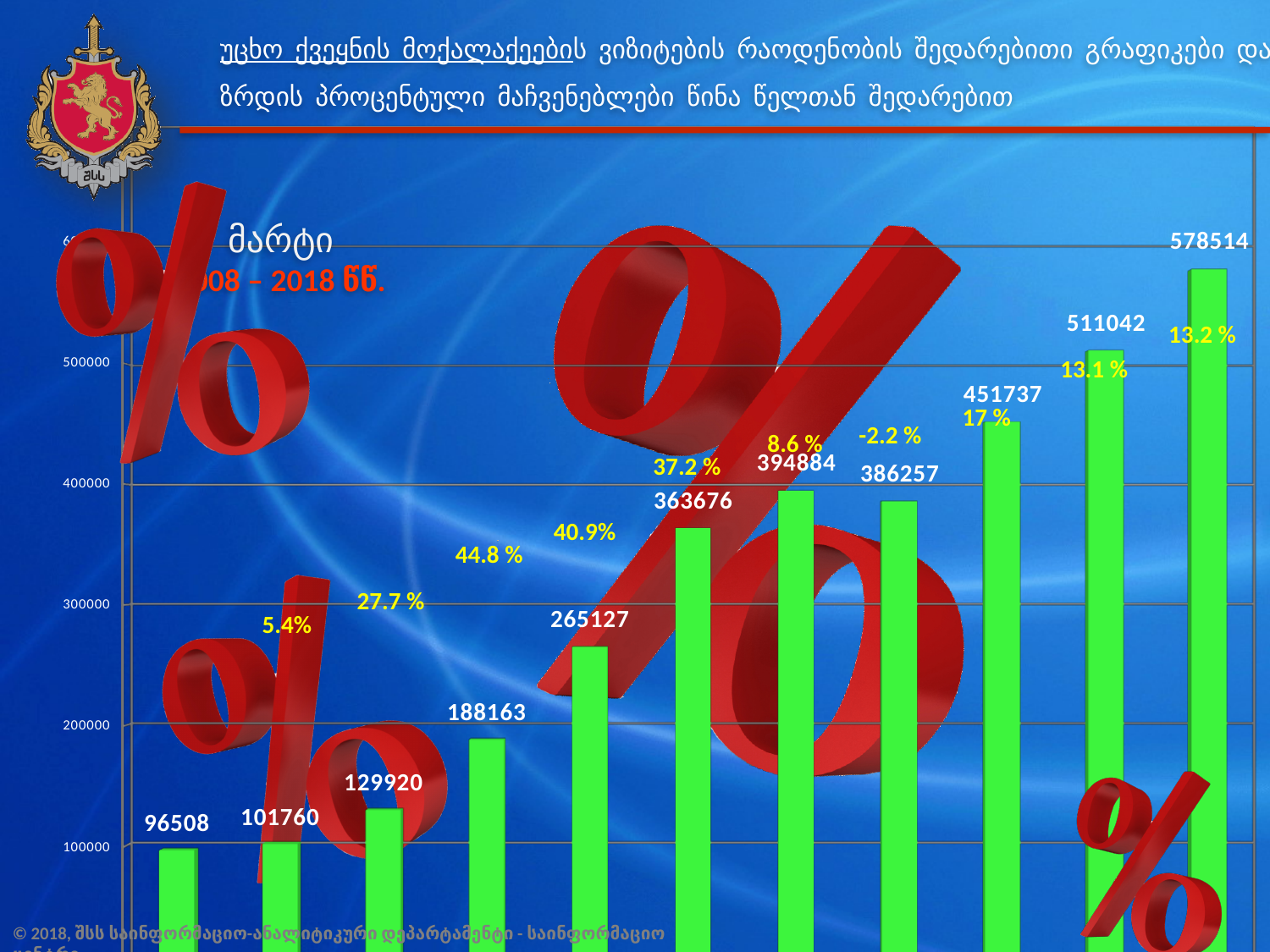
Do the bar values generally rise or fall from left to right across the chart? rise What is the value labelled on the first (leftmost) bar? 96508 How many bars are plotted in the chart? 11 What is the lowest value labelled on any bar in the chart? 96508 What is the highest value labelled on any bar in the chart? 578514 What kind of chart is shown on the slide? bar chart What is the difference between the value of the last bar (578514) and the first bar (96508)? 482006 What is the value labelled on the fourth bar from the left? 188163 Which percentage label in the chart is negative? -2.2 % What colour are the bars in the chart? green Is the value of the bar labelled 265127 greater or less than 300000? less Which is larger, the bar labelled 394884 or the bar labelled 386257? 394884